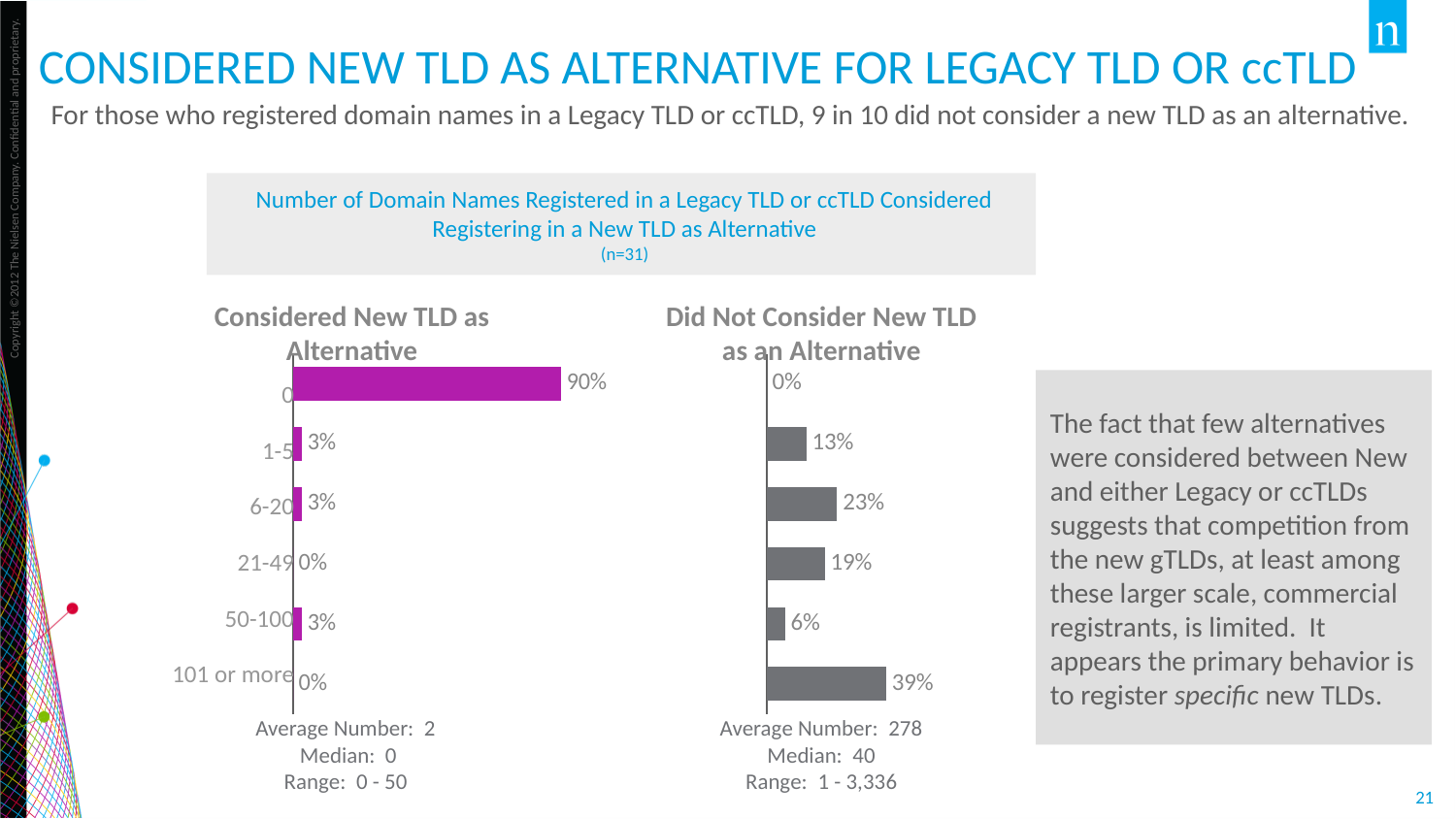
In the 'Did Not Consider New TLD as an Alternative' chart, which is larger: the value for '1-5' or the value for '50-100'? 1-5 What is the sample size (n) stated in the chart title box? n=31 In the 'Did Not Consider New TLD as an Alternative' chart, which category has the lowest value? 0 In the 'Considered New TLD as Alternative' chart, what is the value for the '0' category? 90% What type of chart is the 'Did Not Consider New TLD as an Alternative' chart? Bar chart In the 'Did Not Consider New TLD as an Alternative' chart, which category has the highest value? 101 or more In the 'Did Not Consider New TLD as an Alternative' chart, what is the value for '101 or more'? 39% How many categories are shown in the 'Considered New TLD as Alternative' chart? 6 In the 'Did Not Consider New TLD as an Alternative' chart, what is the value for '6-20'? 23% In the 'Considered New TLD as Alternative' chart, what is the value for '50-100'? 3% In the 'Did Not Consider New TLD as an Alternative' chart, what is the difference between the values for '6-20' and '21-49'? 4% In the 'Considered New TLD as Alternative' chart, which category has the highest value? 0